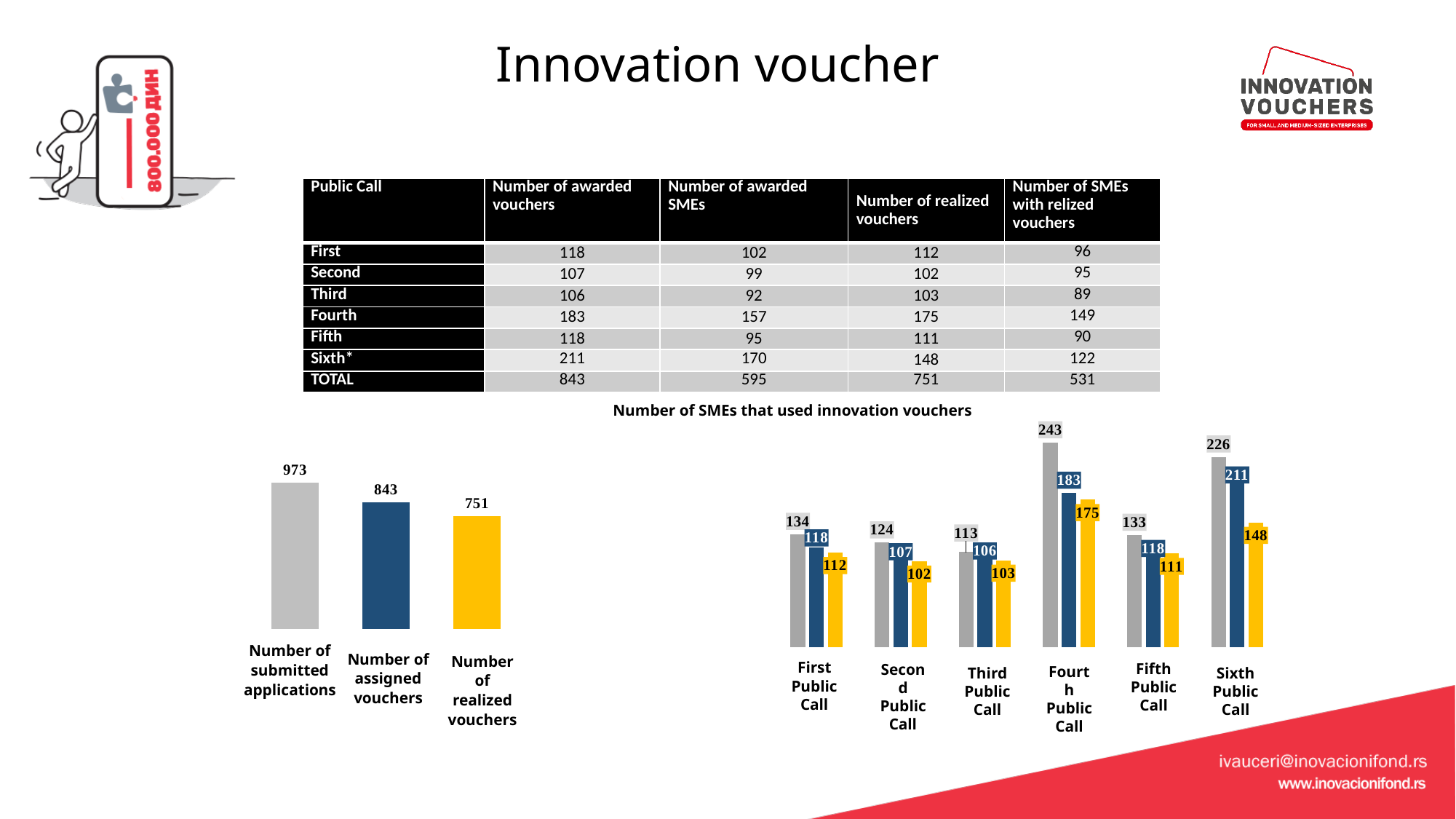
On the right chart, what is the difference between the blue bar and the yellow bar for Sixth Public Call? 63 On the right chart, which public call has the highest gray bar? Fourth Public Call On the right chart, what is the value of the gray bar for Fourth Public Call? 243 On the right chart, how many public calls are shown on the x axis? 6 On the left chart, how many bars are plotted? 3 On the left chart, what is the value for Number of submitted applications? 973 On the right chart, which public call has the lowest gray bar? Third Public Call What kind of chart is the left chart? Bar chart On the left chart, which category has the highest value? Number of submitted applications On the left chart, what is the difference between Number of submitted applications and Number of assigned vouchers? 130 On the right chart, what is the value of the yellow bar for Sixth Public Call? 148 On the left chart, what is the value for Number of realized vouchers? 751